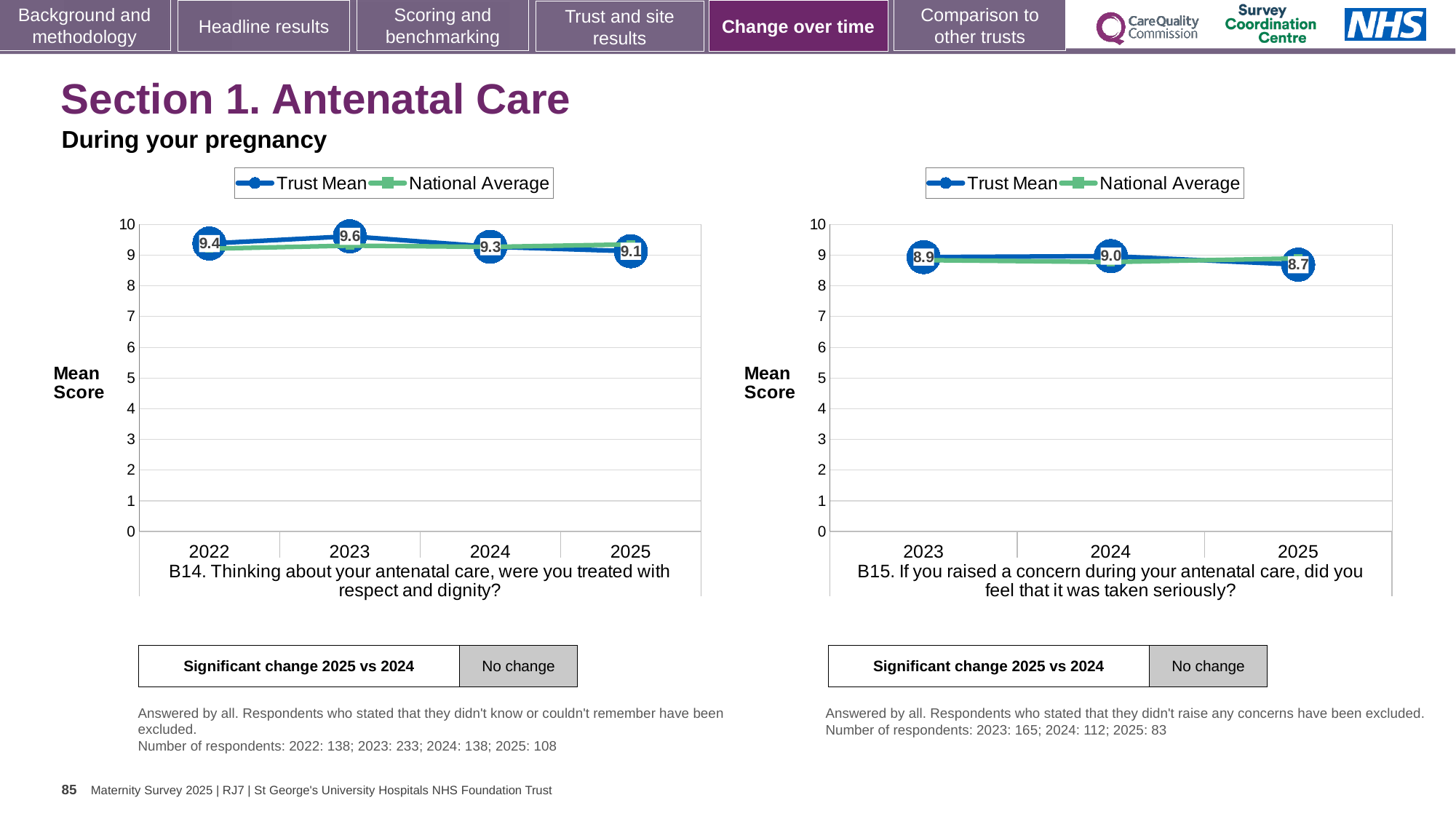
In the B15 chart (right), which year has the lowest Trust Mean? 2025 In the B14 chart (left), what is the Trust Mean for 2023? 9.6 What kind of chart is the B14 chart (left)? Line chart How many series does the legend of the B15 chart (right) list? 2 In the B14 chart (left), which year has the highest Trust Mean? 2023 In the B14 chart (left), how many years are plotted on the x axis? 4 In the B14 chart (left), what is the difference between the Trust Mean in 2023 and in 2025? 0.5 In the B15 chart (right), what is the Trust Mean for 2025? 8.7 In the B14 chart (left), which year has the lowest Trust Mean? 2025 In the B15 chart (right), what is the Trust Mean for 2024? 9.0 In the B14 chart (left), what is the Trust Mean for 2025? 9.1 In the B15 chart (right), is the Trust Mean for 2023 larger or smaller than the Trust Mean for 2024? smaller